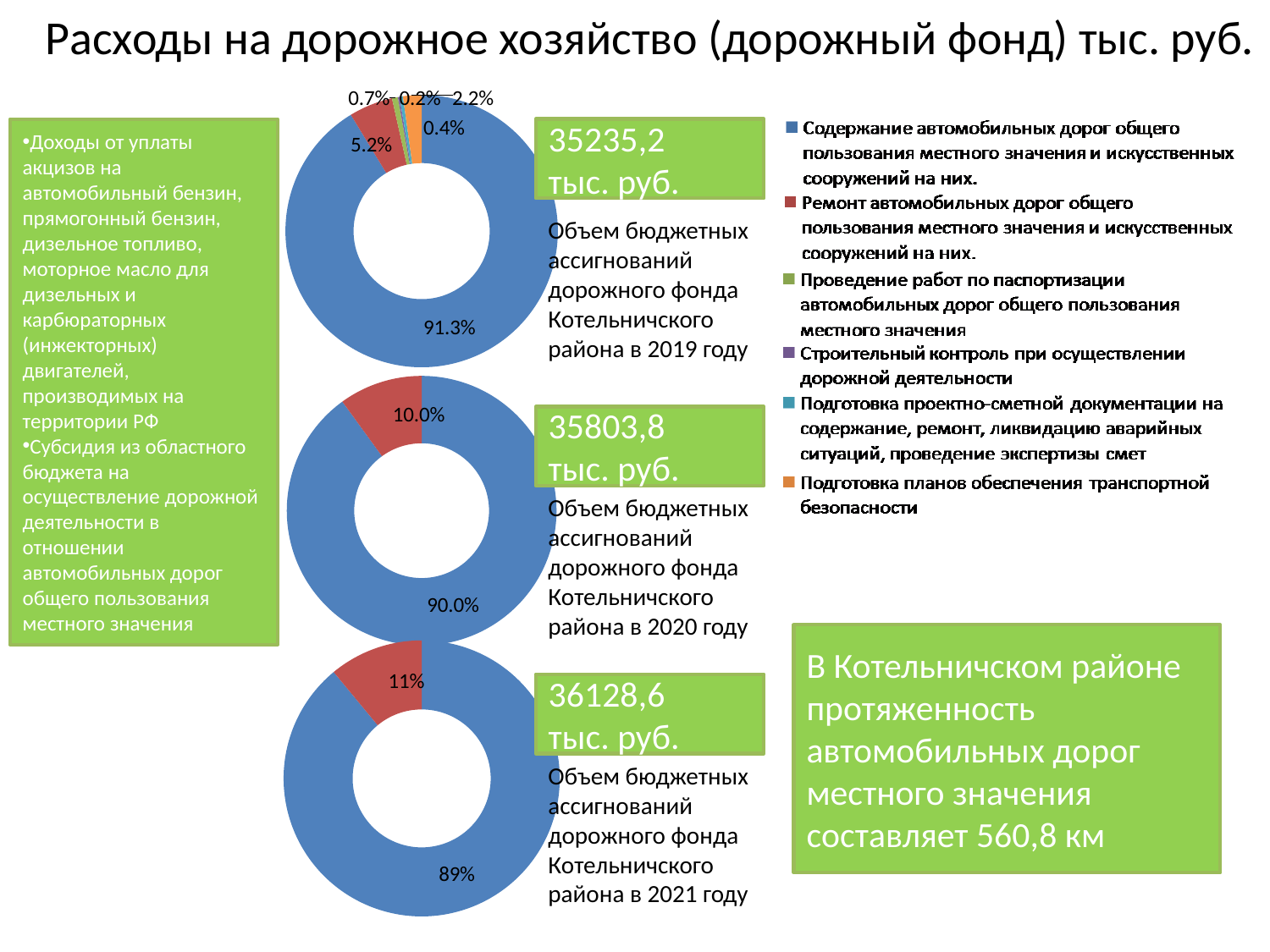
In the 2019 doughnut chart (top), what share is shown for the blue slice, maintenance of local public roads (Содержание автомобильных дорог)? 91.3% In the 2020 doughnut chart (middle), what share is shown for the red slice, repair of roads? 10.0% In the 2021 doughnut chart (bottom), what share is shown for the red slice, repair of roads? 11% In the 2019 doughnut chart (top), what is the difference between the maintenance share (91.3%) and the repair share (5.2%)? 86.1% Which is larger: the repair share in the 2020 chart (middle) or the repair share in the 2021 chart (bottom)? 2021 chart (11%) In the 2019 doughnut chart (top), what share is shown for the red slice, repair of local public roads (Ремонт автомобильных дорог)? 5.2% How many series does the legend on the right list? 6 What type of chart is used to show the road fund expenditure structure for each year? Doughnut (pie) chart In the 2019 doughnut chart (top), which category has the largest share? Содержание автомобильных дорог общего пользования местного значения и искусственных сооружений на них In the 2020 doughnut chart (middle), what is the difference between the maintenance share and the repair share? 80.0% In the 2021 doughnut chart (bottom), what share is shown for the blue slice, maintenance of roads? 89% What total budget allocation is shown next to the 2020 doughnut chart (middle)? 35803,8 тыс. руб.